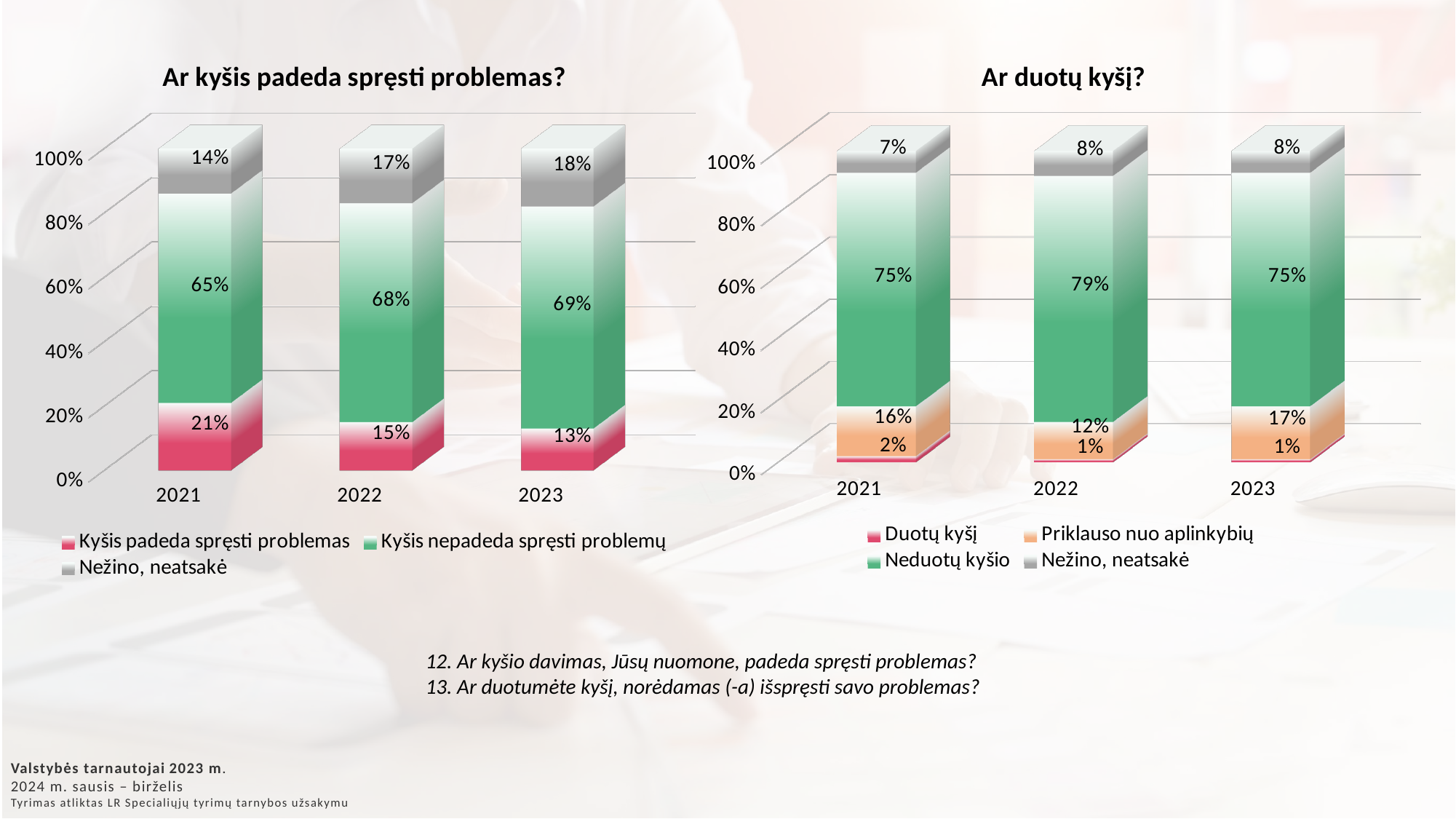
In the chart 'Ar kyšis padeda spręsti problemas?', in which year is the 'Kyšis padeda spręsti problemas' value lowest? 2023 What kind of chart is 'Ar duotų kyšį?'? stacked bar chart In the chart 'Ar duotų kyšį?', what is the value for 'Neduotų kyšio' in 2022? 79% In the chart 'Ar duotų kyšį?', in which year is the 'Neduotų kyšio' value highest? 2022 In the chart 'Ar kyšis padeda spręsti problemas?', what is the value for 'Kyšis padeda spręsti problemas' in 2021? 21% In the chart 'Ar kyšis padeda spręsti problemas?', what is the value for 'Kyšis nepadeda spręsti problemų' in 2023? 69% In the chart 'Ar kyšis padeda spręsti problemas?', does the 'Kyšis nepadeda spręsti problemų' value rise or fall from 2021 to 2023? rise In the chart 'Ar kyšis padeda spręsti problemas?', what is the difference between the 'Nežino, neatsakė' values for 2023 and 2021? 4% In the chart 'Ar duotų kyšį?', which is larger: the 'Priklauso nuo aplinkybių' value in 2021 or in 2022? 2021 In the chart 'Ar duotų kyšį?', what is the value for 'Priklauso nuo aplinkybių' in 2023? 17% In the chart 'Ar kyšis padeda spręsti problemas?', how many series does the legend list? 3 In the chart 'Ar duotų kyšį?', how many series does the legend list? 4